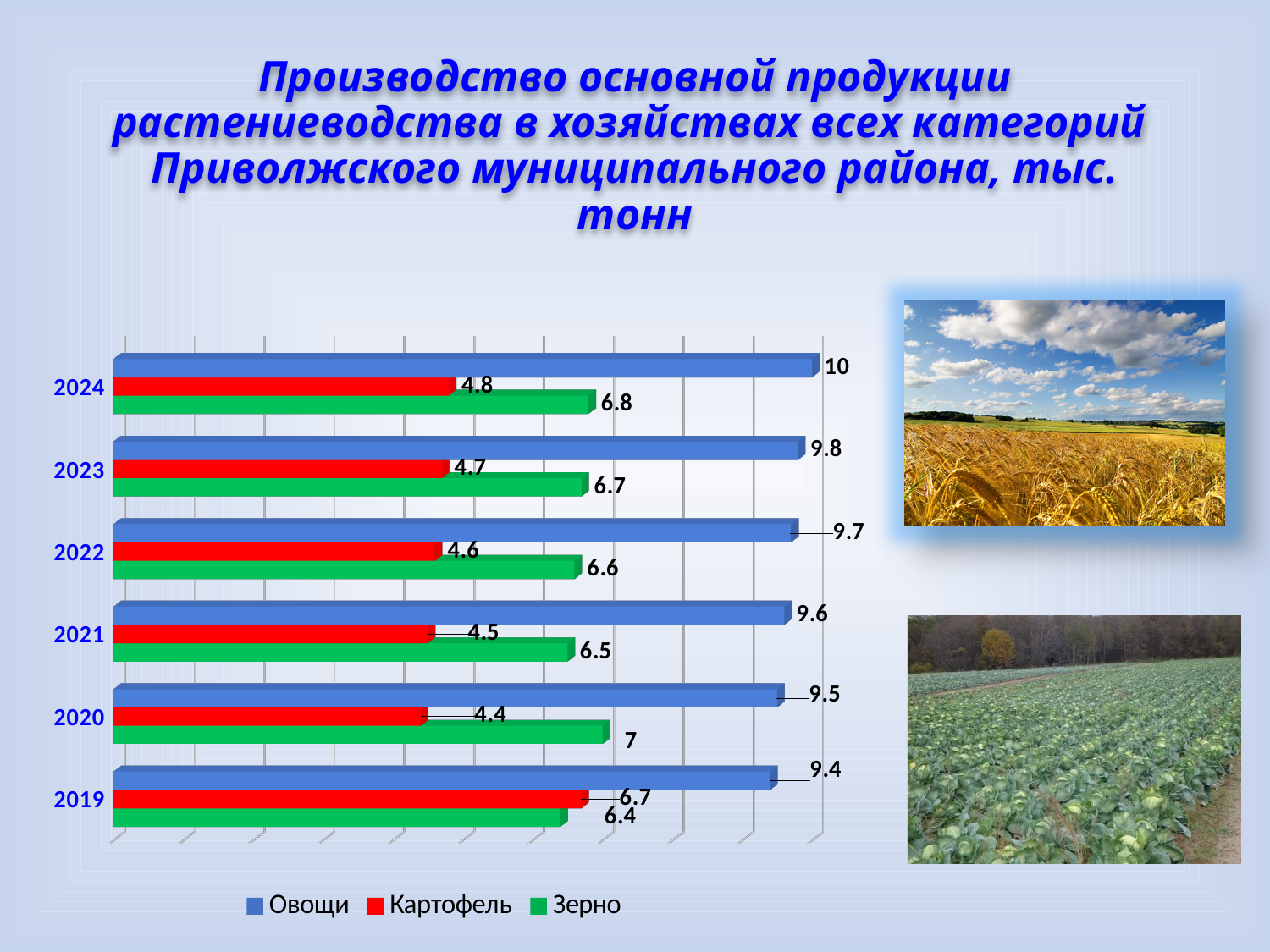
In which year is the value for Овощи the highest? 2024 What is the difference between the Овощи value in 2024 and in 2019? 0.6 In which year is the value for Картофель the lowest? 2020 What is the value for Картофель in 2019? 6.7 What is the value for Овощи in 2024? 10 What is the value for Картофель in 2022? 4.6 What is the value for Зерно in 2020? 7 How many years are shown on the chart? 6 Which colour represents Зерно in the chart? green Which is larger in 2019: the value for Картофель or the value for Зерно? Картофель How many series does the legend list? 3 What kind of chart is shown on the slide? bar chart